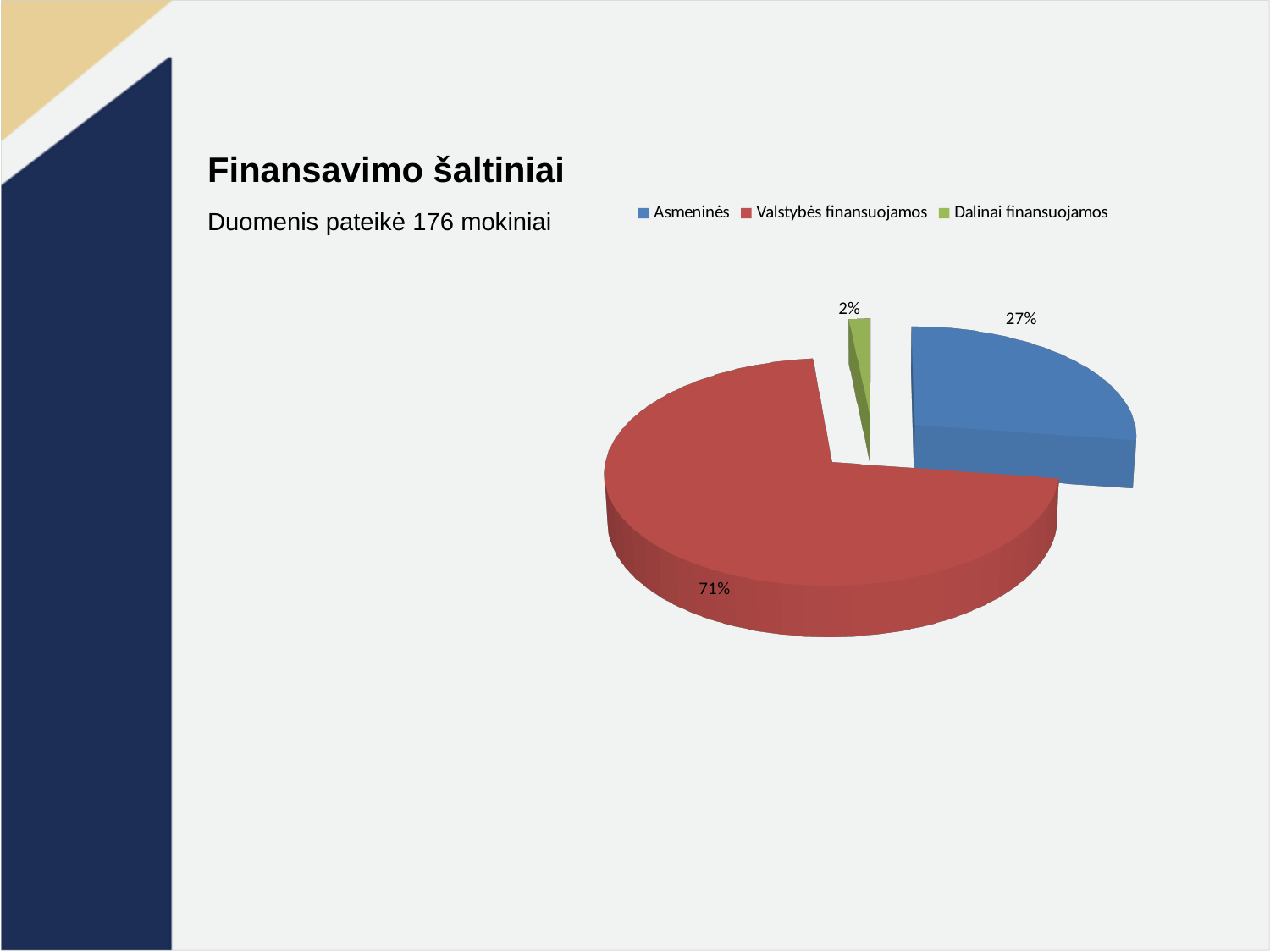
What is the difference in percentage points between Valstybės finansuojamos and Asmeninės? 44 How many entries does the legend list? 3 Which category has the smallest slice of the pie? Dalinai finansuojamos What share of the pie does Asmeninės have? 27% What kind of chart is shown on the slide? pie chart What is the difference in percentage points between Asmeninės and Dalinai finansuojamos? 25 What share of the pie does Dalinai finansuojamos have? 2% What colour is the slice for Valstybės finansuojamos? red What share of the pie does Valstybės finansuojamos have? 71% Which category has the largest slice of the pie? Valstybės finansuojamos How many slices does the pie chart have? 3 Which is larger, the slice for Asmeninės or the slice for Dalinai finansuojamos? Asmeninės